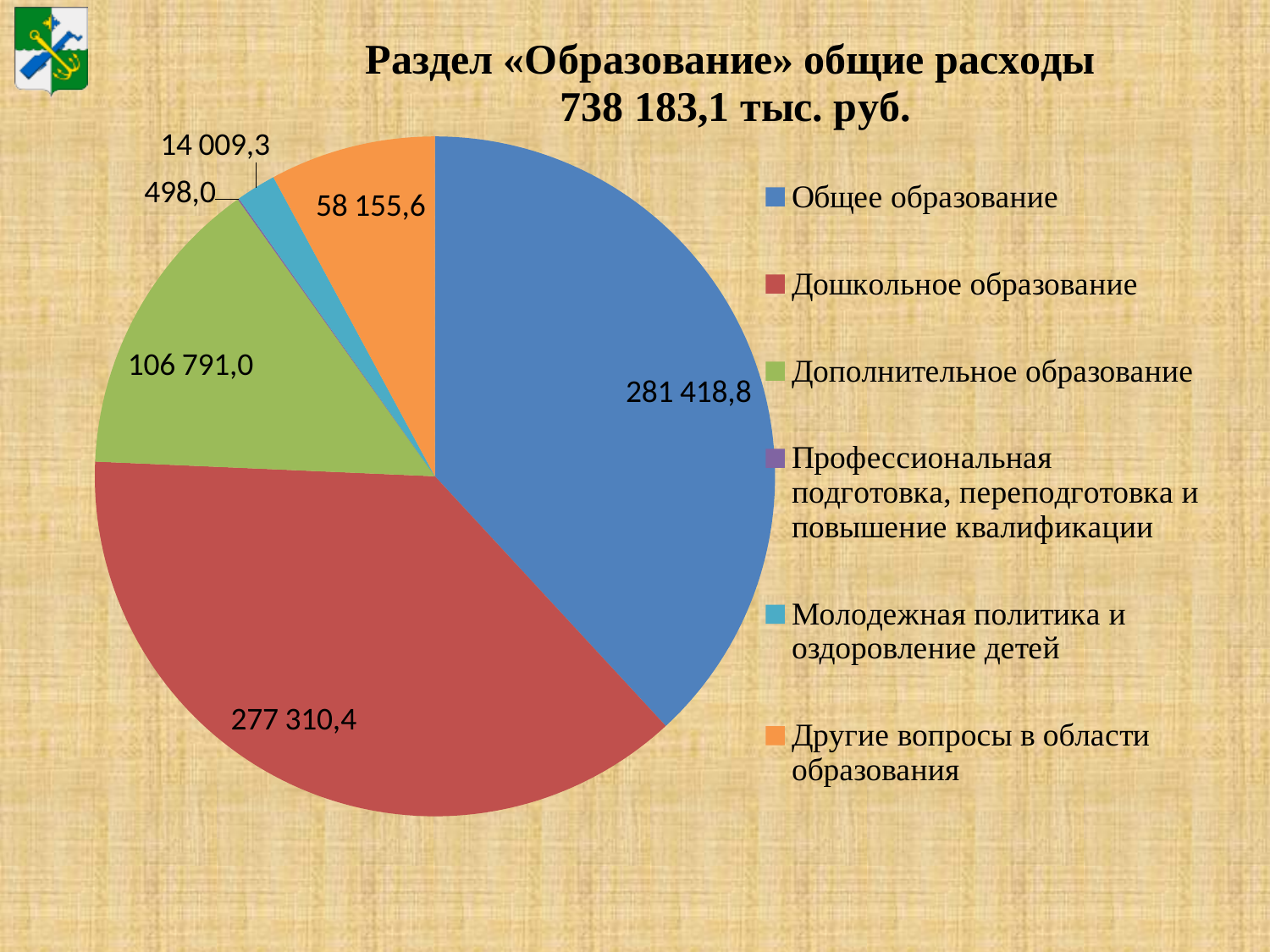
What is the value for Дошкольное образование? 277 310,4 What is the value for Другие вопросы в области образования? 58 155,6 What is the difference between the values for Общее образование and Дошкольное образование? 4 108,4 What is the value for Молодежная политика и оздоровление детей? 14 009,3 Which category has the largest slice of the pie? Общее образование What is the value for Общее образование? 281 418,8 What is the value for Дополнительное образование? 106 791,0 Which is larger: the value for Дополнительное образование or the value for Другие вопросы в области образования? Дополнительное образование Which category has the smallest slice of the pie? Профессиональная подготовка, переподготовка и повышение квалификации How many categories does the pie chart have? 6 What kind of chart is shown on the slide? Pie chart What colour is the slice for Дошкольное образование? Red